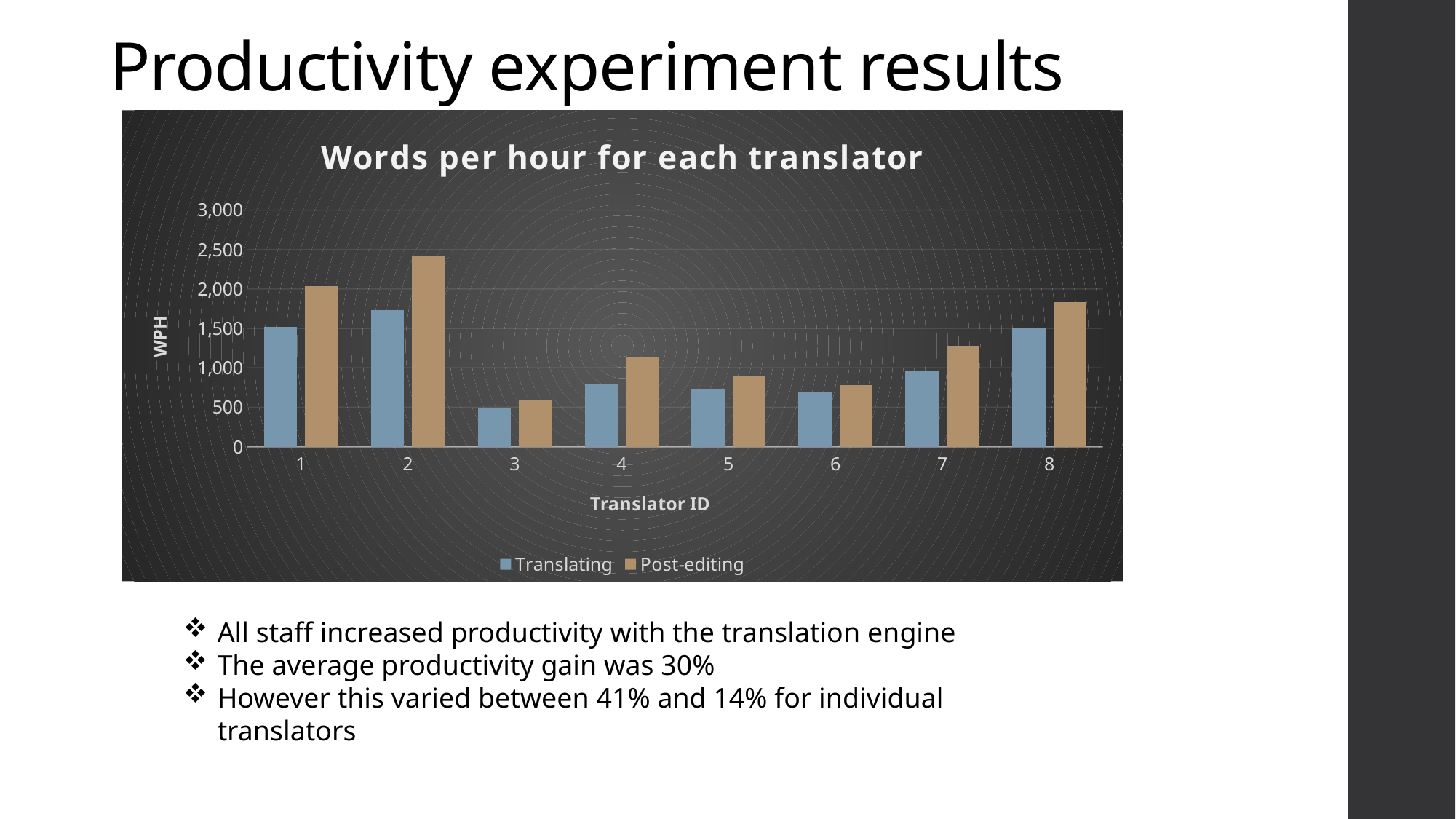
Which translator has the lowest Translating value? 3 Is the Post-editing value for translator 8 greater or less than 2,000? less Which translator has the highest Post-editing value? 2 Is the Translating value for translator 6 greater or less than 500? greater Which translator has the highest Translating value? 2 How many translator IDs are shown on the x axis? 8 What label is shown on the y axis? WPH Is the Post-editing value for translator 2 greater or less than 2,000? greater What kind of chart is shown on the slide? Bar chart How many series does the legend list? 2 What is the title of the chart? Words per hour for each translator Which is larger: the Post-editing value for translator 4 or the Post-editing value for translator 7? Translator 7